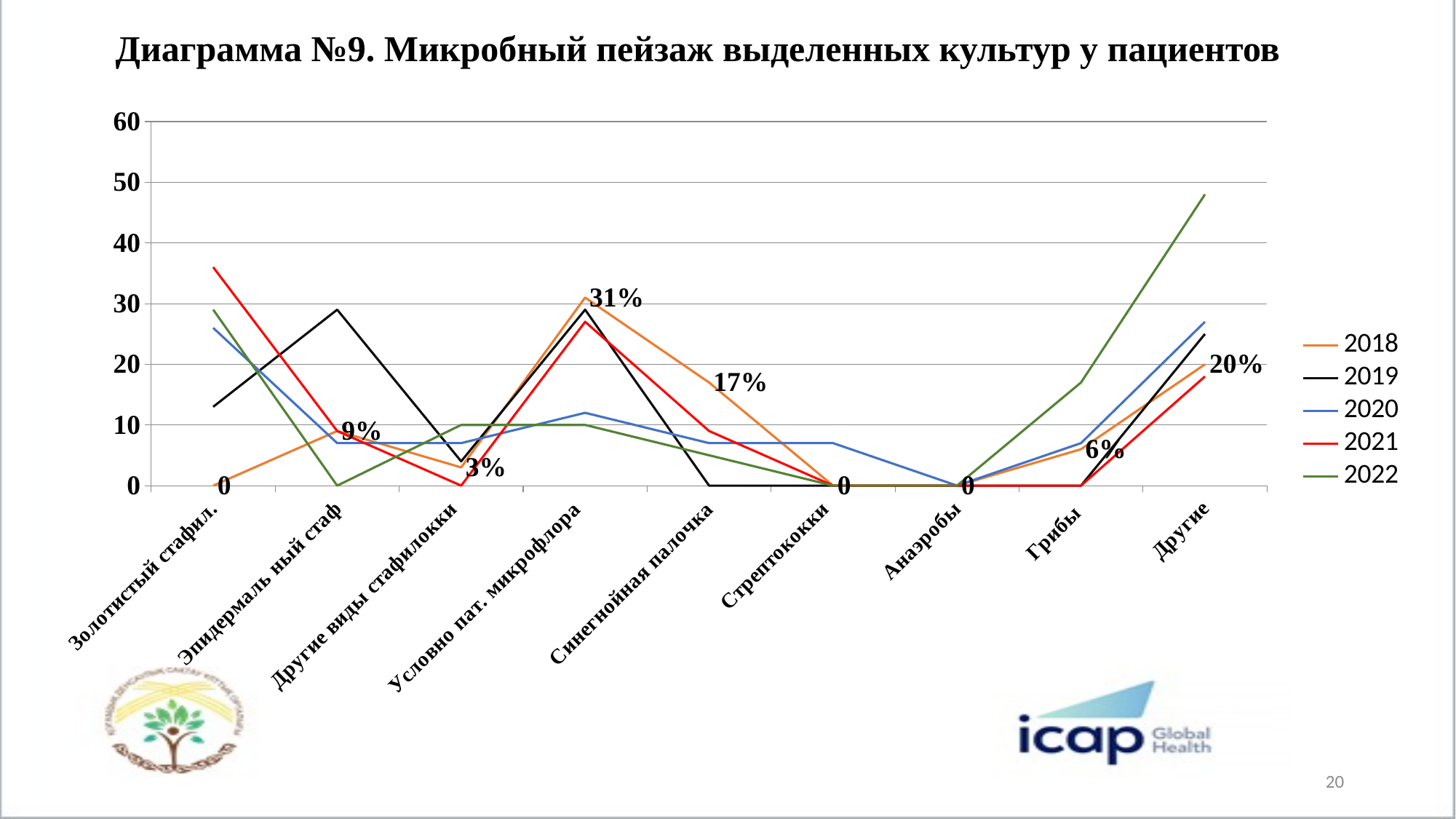
What is the difference between the 2018 values for Условно пат. микрофлора and Синегнойная палочка? 14% What kind of chart is shown on the slide? line chart What is the 2018 value for Грибы? 6% What is the 2018 value for Другие? 20% For Другие, which series has the larger value, 2022 or 2018? 2022 What is the title of the chart? Диаграмма №9. Микробный пейзаж выделенных культур у пациентов How many series does the legend list? 5 Is the 2022 value for Другие greater or less than 40? greater How many categories are shown along the x axis? 9 What is the 2018 value for Синегнойная палочка? 17% Which category has the highest value for the 2018 series? Условно пат. микрофлора What is the 2018 value for Условно пат. микрофлора? 31%